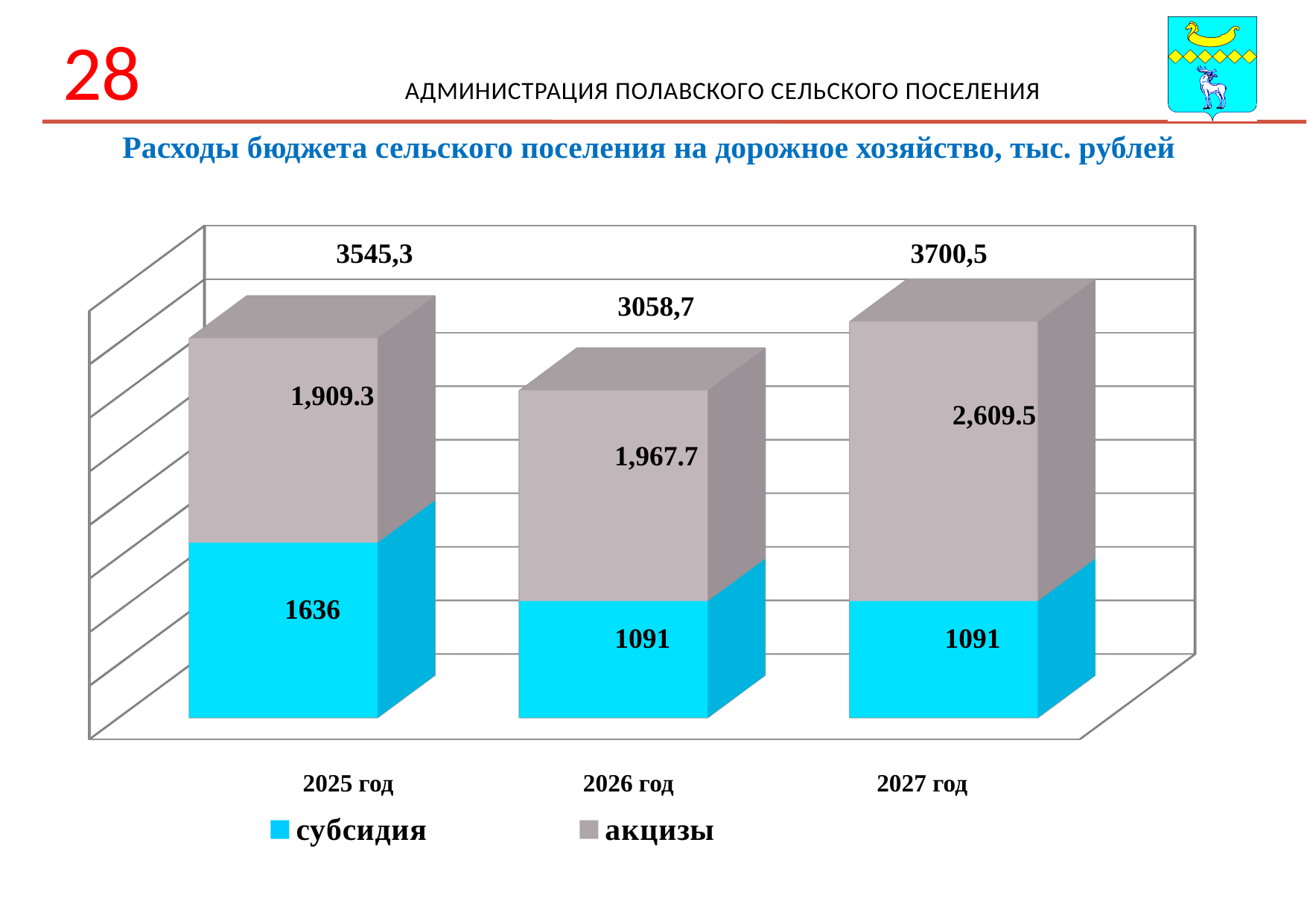
How many series does the legend list? 2 What is the value of субсидия for 2027 год? 1091 What kind of chart is shown on the slide? stacked bar chart Is the акцизы value for 2027 год larger or smaller than the акцизы value for 2025 год? larger What is the value of акцизы for 2027 год? 2,609.5 What is the difference between the субсидия values for 2025 год and 2026 год? 545 What is the total shown above the stacked bar for 2026 год? 3058,7 Which year has the highest value for акцизы? 2027 год What is the value of акцизы for 2026 год? 1,967.7 What is the value of субсидия for 2025 год? 1636 Which year has the highest value for субсидия? 2025 год What is the total shown above the stacked bar for 2027 год? 3700,5